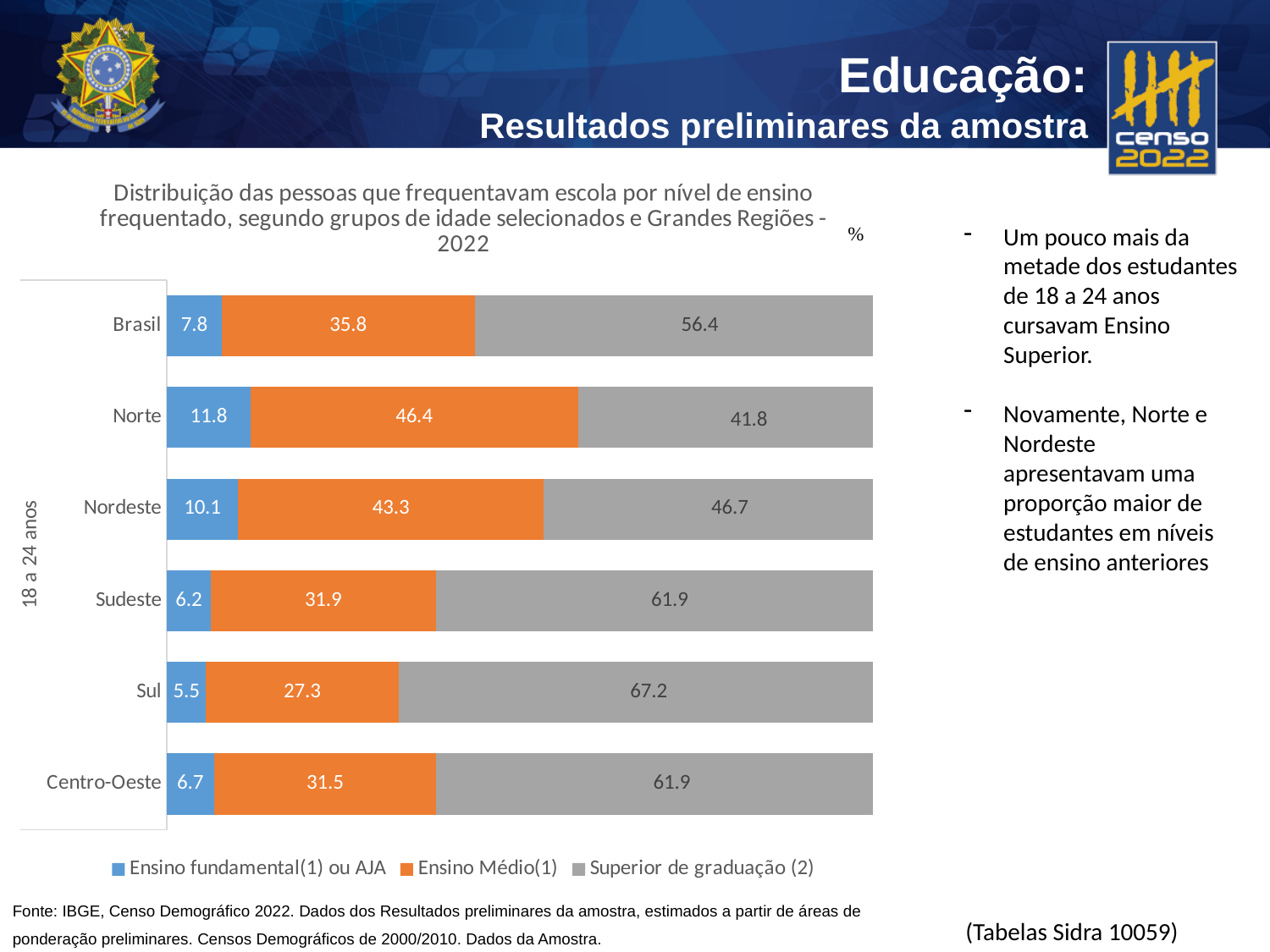
How many regions (categories) are shown in the chart? 6 Which region has the lowest value for Superior de graduação (2)? Norte For Norte, which is larger: Ensino Médio(1) or Superior de graduação (2)? Ensino Médio(1) What type of chart is shown on the slide? Stacked bar chart What is the value for Ensino fundamental(1) ou AJA for Sul? 5.5 Which region has the highest value for Superior de graduação (2)? Sul What is the total of the stacked bar for Sudeste? 100.0 What is the value for Superior de graduação (2) for Brasil? 56.4 What is the value for Ensino Médio(1) for Norte? 46.4 How many series does the legend list? 3 Which region has the highest value for Ensino fundamental(1) ou AJA? Norte What is the difference between the Superior de graduação (2) values for Sul and Norte? 25.4